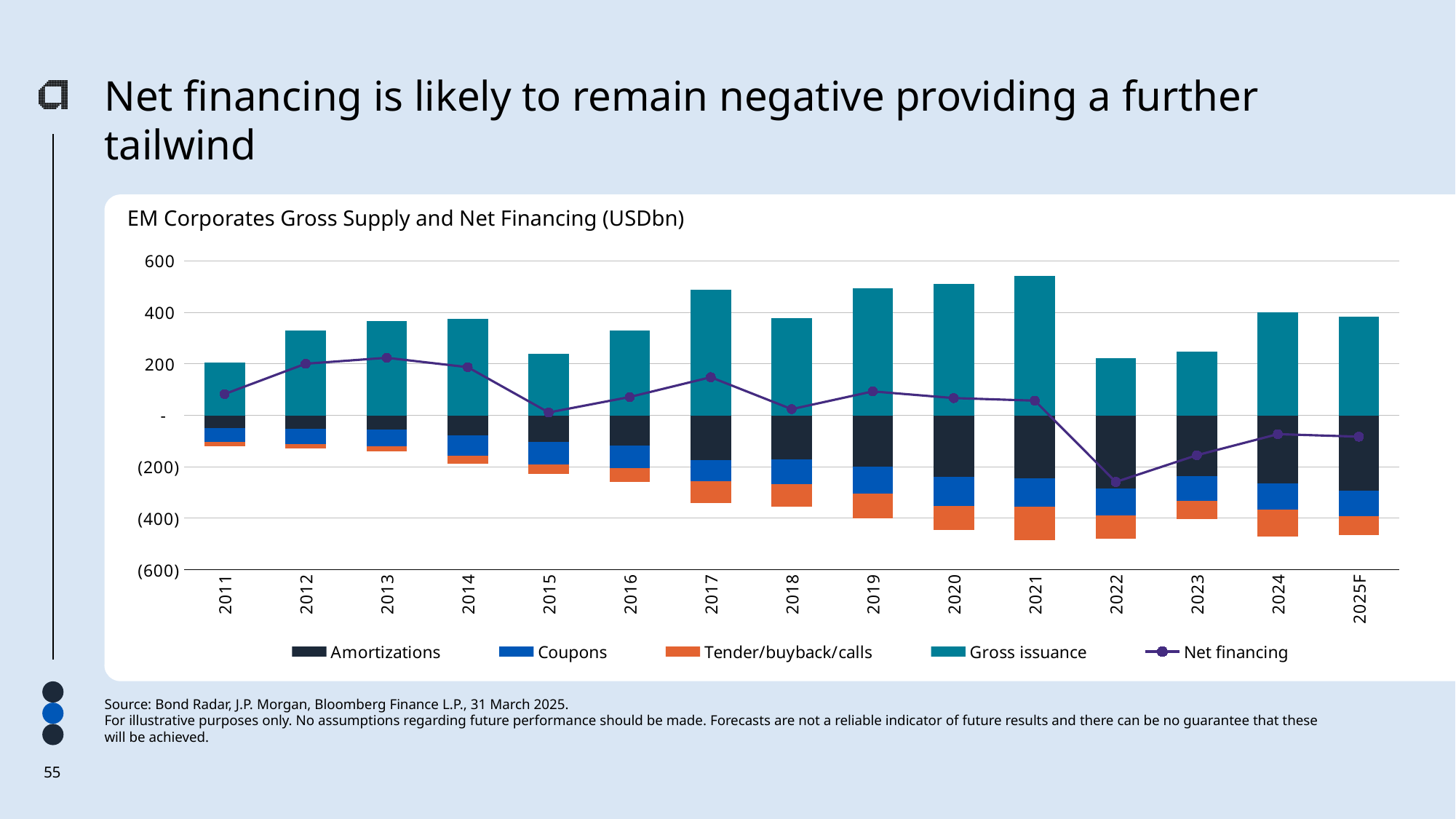
How many years are shown on the x axis of the chart? 15 Is the Gross issuance value for 2021 greater or less than 400? greater How many series does the chart legend list? 5 In which year is Gross issuance highest? 2021 What kind of chart is shown on the slide? Stacked bar chart with a line In which year is Net financing lowest? 2022 Is the Gross issuance value for 2011 greater or less than 400? less Which series is shown in orange in the legend? Tender/buyback/calls Does Net financing rise or fall from 2021 to 2022? fall Which year has the larger Gross issuance, 2021 or 2011? 2021 What is the title of the chart? EM Corporates Gross Supply and Net Financing (USDbn) Is the Net financing value for 2022 greater or less than (200)? less